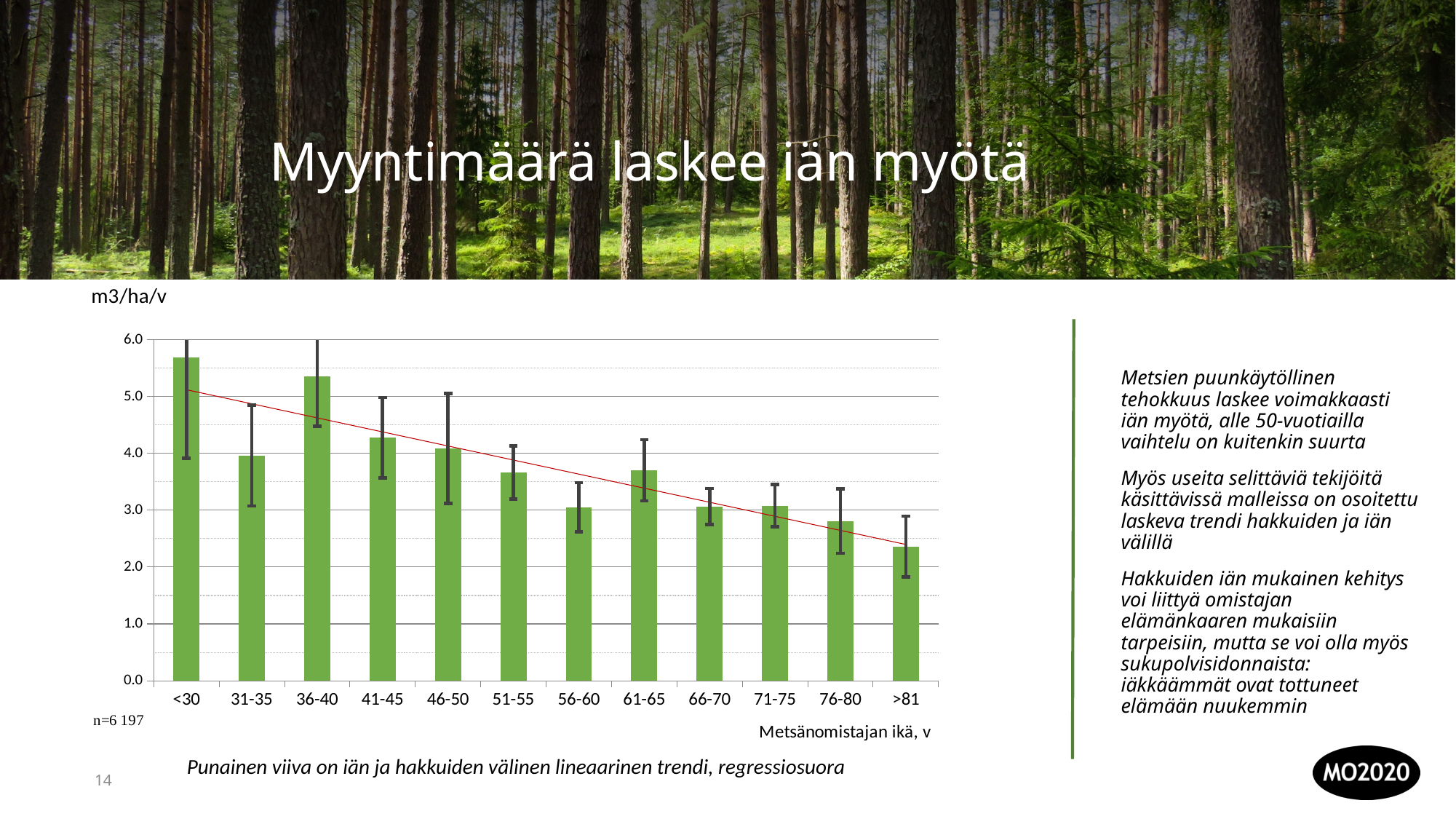
Which has the larger value, the 31-35 age group or the 36-40 age group? 36-40 Which has the larger value, the 41-45 age group or the 51-55 age group? 41-45 Do the values generally rise or fall as the owner's age increases along the x axis? fall Is the value for the 61-65 age group greater or less than 3.0? greater Is the value for the 36-40 age group greater or less than 5.0? greater Is the value for the <30 age group greater or less than 5.0? greater What kind of chart is shown on the slide? bar chart Which age category has the highest value in the chart? <30 Which age category has the lowest value in the chart? >81 How many age categories are shown on the x axis of the chart? 12 What unit is shown on the y axis of the chart? m3/ha/v